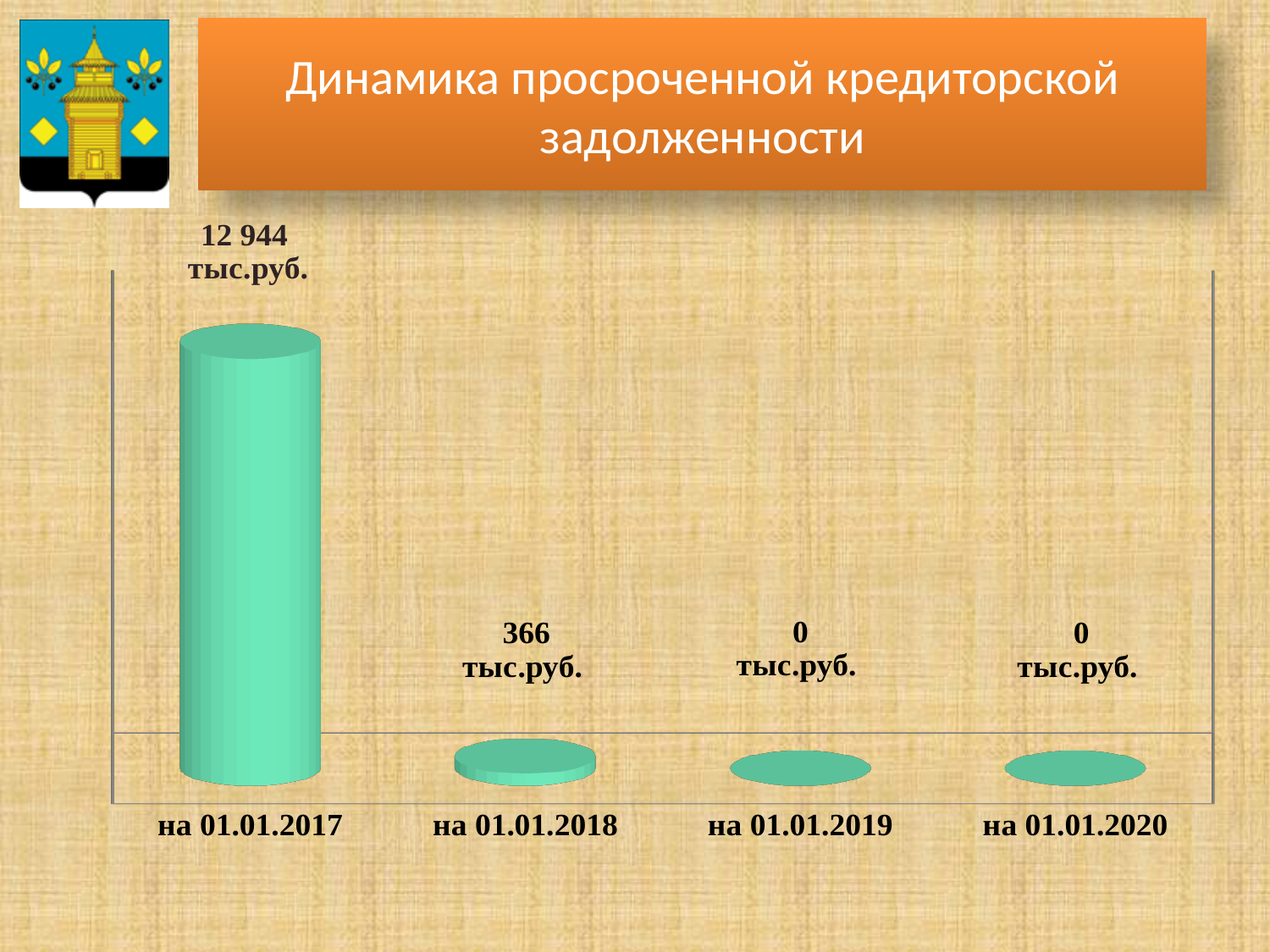
What colour are the bars in the chart? green Do the values rise or fall from на 01.01.2017 to на 01.01.2020? fall What is the value for на 01.01.2017? 12 944 тыс.руб. What is the difference between the values for на 01.01.2017 and на 01.01.2018? 12 578 тыс.руб. What is the value for на 01.01.2020? 0 тыс.руб. What kind of chart is shown on the slide? bar chart What is the value for на 01.01.2019? 0 тыс.руб. How many categories are shown on the x axis? 4 What is the title of the chart? Динамика просроченной кредиторской задолженности What is the value for на 01.01.2018? 366 тыс.руб. Which category has the highest value? на 01.01.2017 Which is larger, the value for на 01.01.2018 or the value for на 01.01.2019? на 01.01.2018